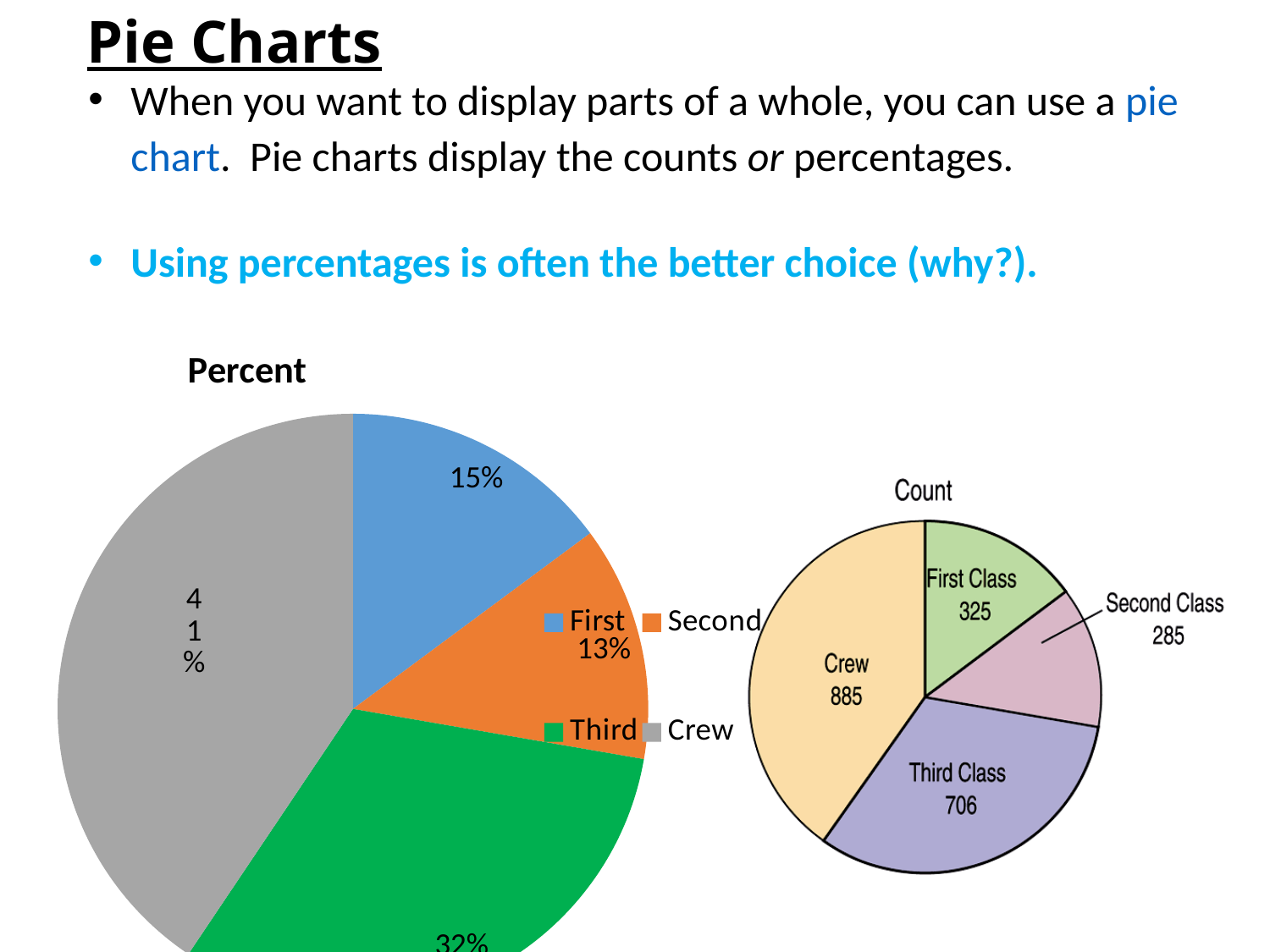
In the Percent pie chart, what percentage is shown for the Second slice? 13% In the Percent pie chart, what percentage is shown for the First slice? 15% In the Count pie chart, what is the count for Crew? 885 How many slices does the Count pie chart have? 4 In the Count pie chart, which is larger, First Class or Second Class? First Class In the Count pie chart, what is the count for Second Class? 285 In the Count pie chart, which category has the largest count? Crew What type of chart is the chart titled Percent? Pie chart In the Count pie chart, which category has the smallest count? Second Class In the Count pie chart, what is the difference between the Crew count and the Third Class count? 179 In the Percent pie chart, what percentage is shown for the Third slice? 32% In the Count pie chart, what is the count for Third Class? 706